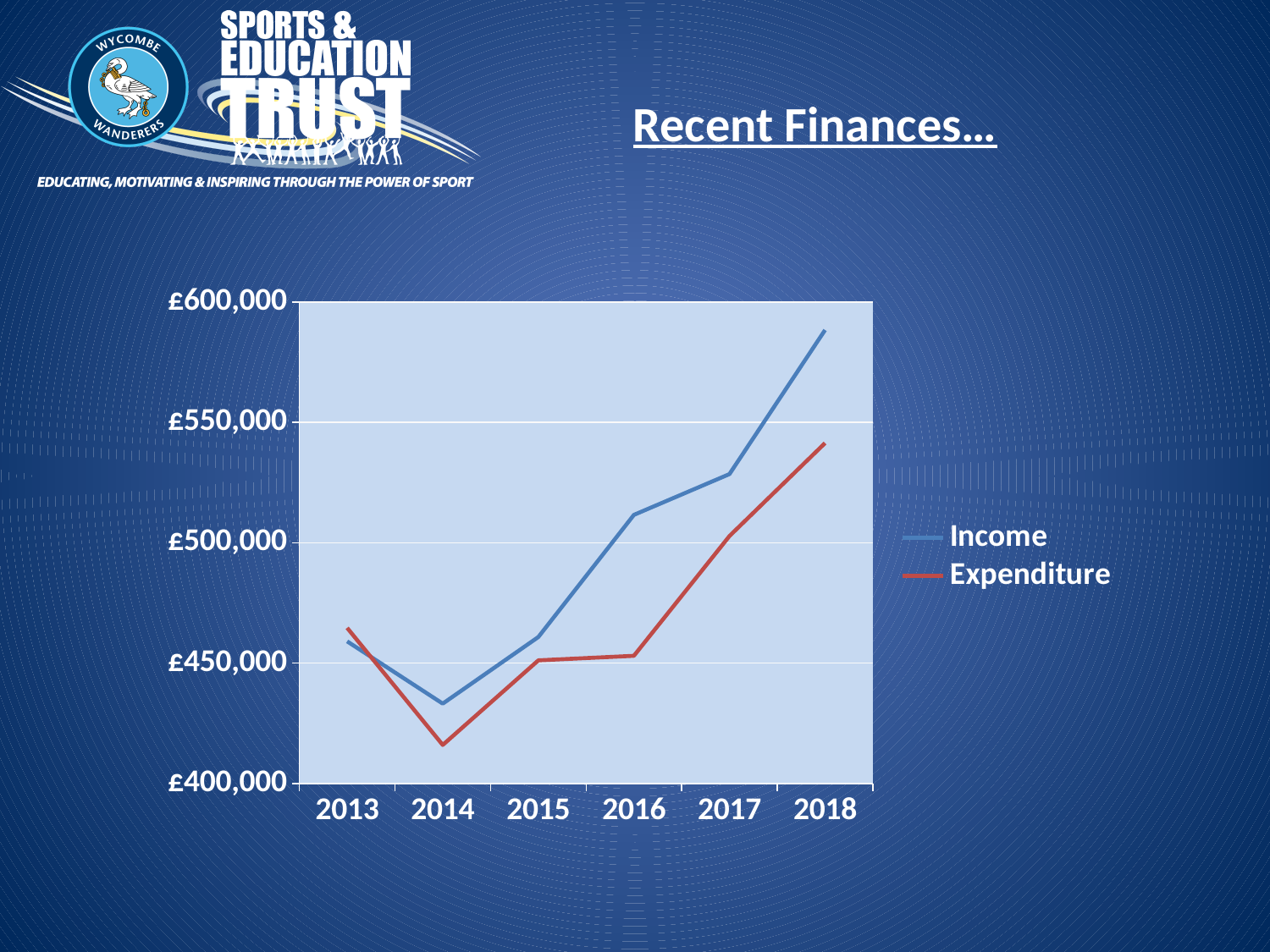
What kind of chart is shown on the slide? Line chart Is the Expenditure value for 2014 greater or less than £450,000? less Which is larger in 2016, Income or Expenditure? Income In which year is Expenditure highest? 2018 Does Income rise or fall from 2014 to 2018? Rise In which year is Income highest? 2018 Is the Income value for 2018 greater or less than £550,000? greater In which year is Expenditure lowest? 2014 How many years are shown on the x axis? 6 How many series does the legend list? 2 In which year is Income lowest? 2014 What is the title of the slide containing the chart? Recent Finances…